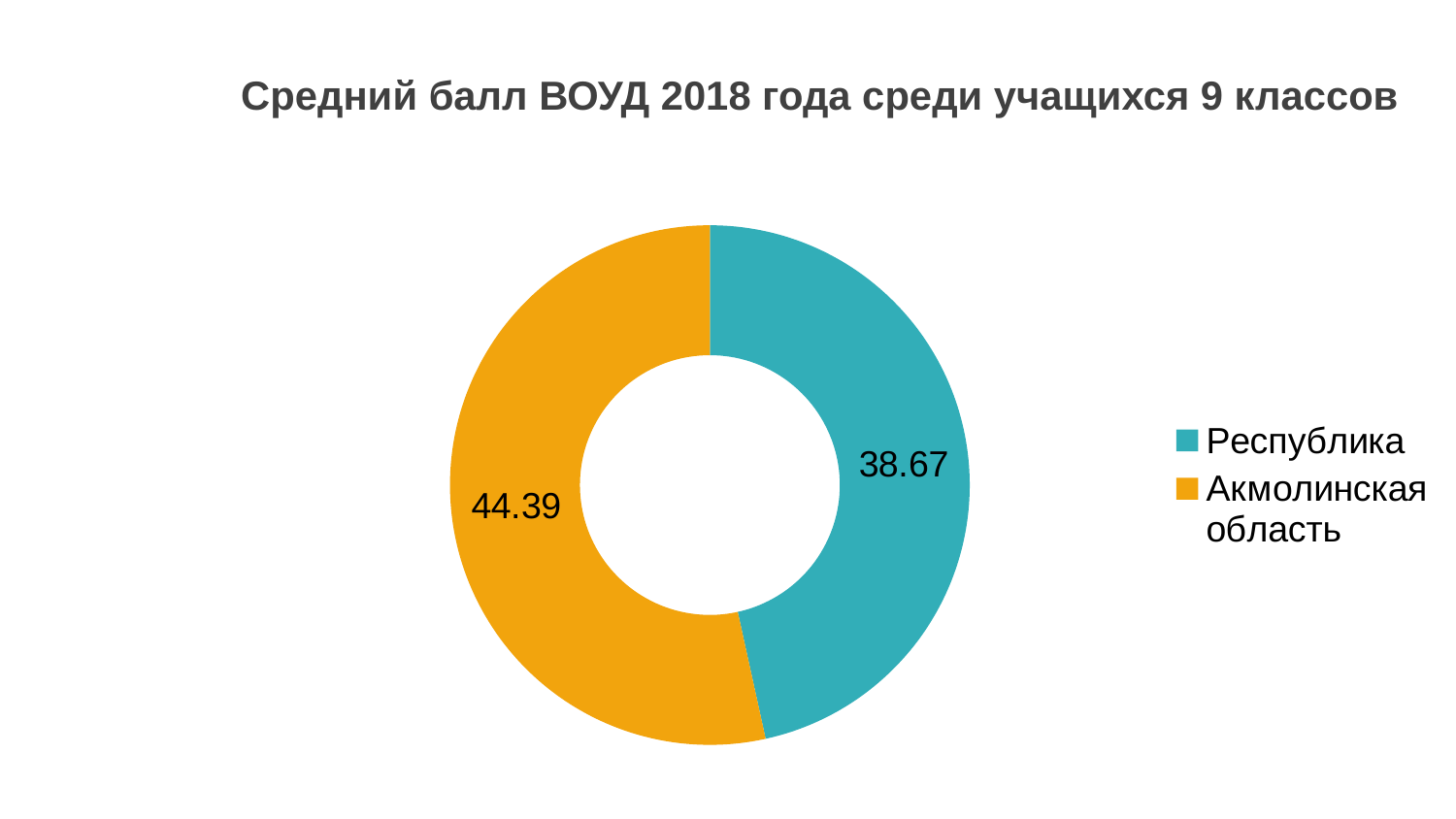
What is the value for Акмолинская область? 44.39 Which is larger, the value for Республика or the value for Акмолинская область? Акмолинская область What colour is the slice for Акмолинская область? Orange How many categories are shown in the chart? 2 How many entries does the legend list? 2 What is the title of the chart? Средний балл ВОУД 2018 года среди учащихся 9 классов What is the difference between the values for Акмолинская область and Республика? 5.72 What kind of chart is shown on the slide? Doughnut (pie) chart Which category has the lowest value? Республика What is the value for Республика? 38.67 Which category has the highest value? Акмолинская область